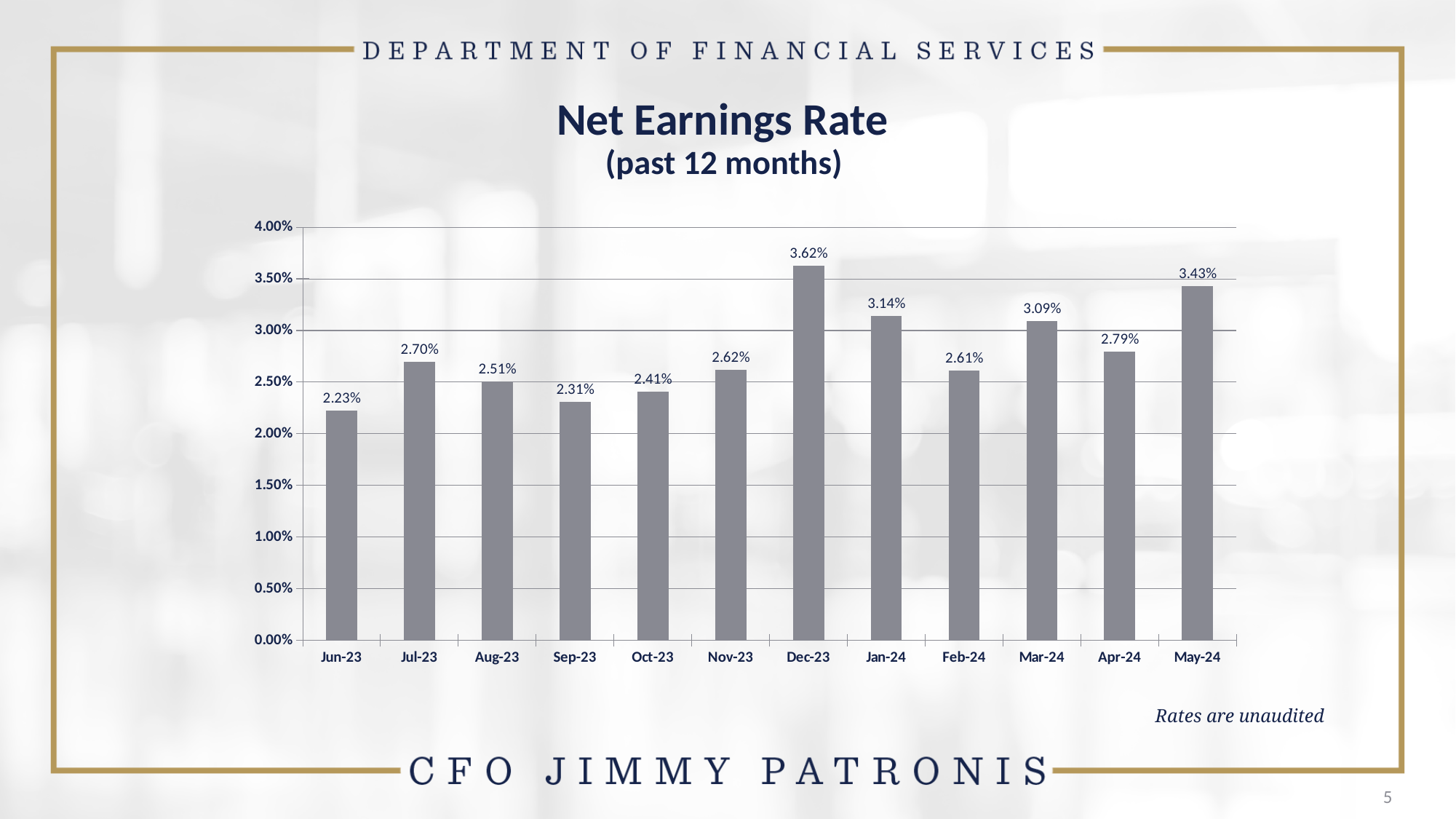
What is the net earnings rate for Dec-23? 3.62% How many months are shown on the chart? 12 What kind of chart is shown on the slide? Bar chart Did the net earnings rate rise or fall from Dec-23 to Jan-24? Fall What is the net earnings rate for Mar-24? 3.09% Which month has a higher net earnings rate, Jan-24 or Mar-24? Jan-24 Is the net earnings rate for Nov-23 greater or less than 3.00%? less What is the net earnings rate for Jun-23? 2.23% What is the difference between the net earnings rate in May-24 and Apr-24? 0.64% What is the title of the chart? Net Earnings Rate (past 12 months) Which month has the lowest net earnings rate? Jun-23 Which month has the highest net earnings rate? Dec-23